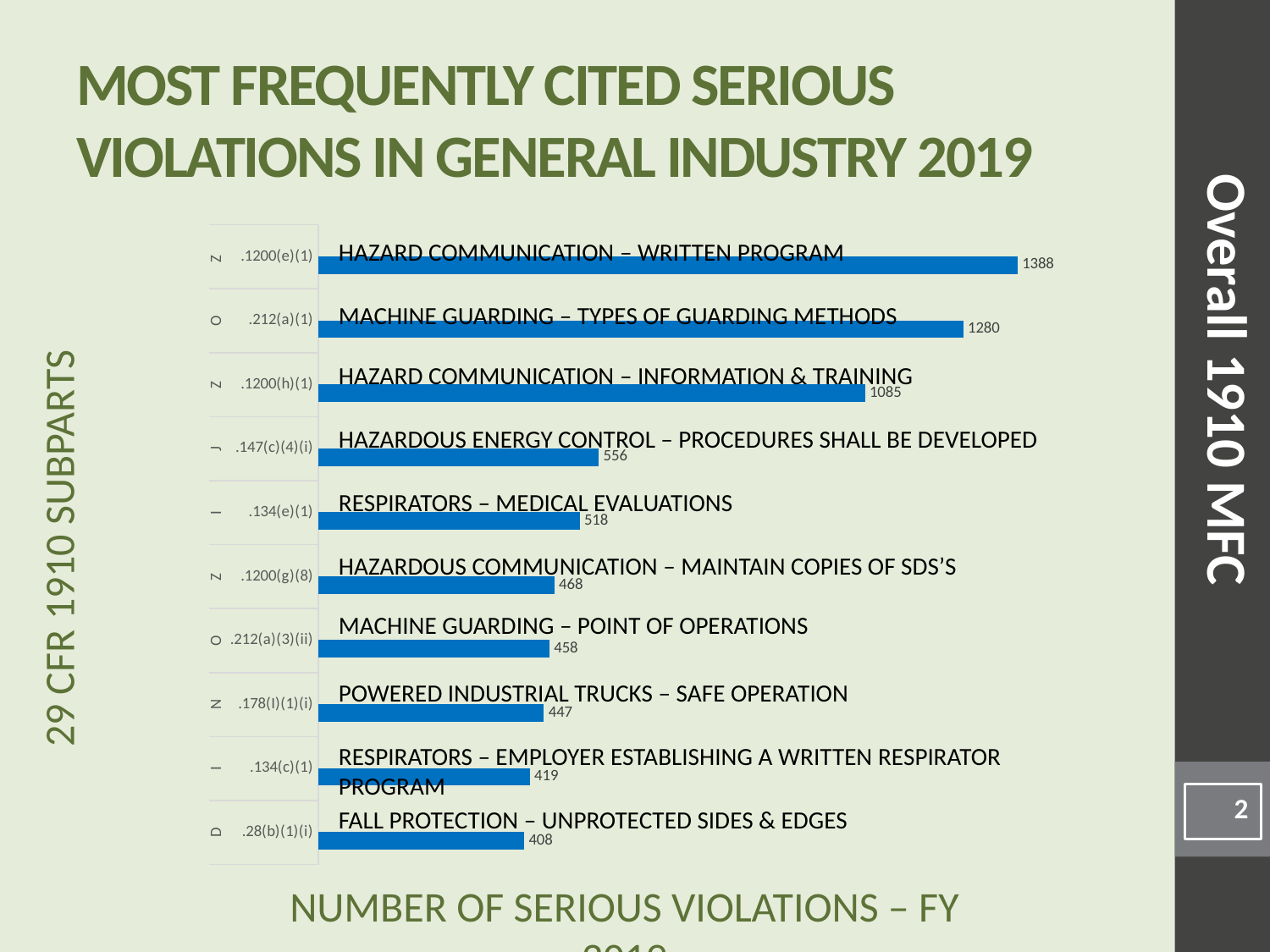
What is the number of serious violations for Hazard Communication – Written Program (.1200(e)(1))? 1388 What is the value shown for Fall Protection – Unprotected Sides & Edges (.28(b)(1)(i))? 408 Which has a larger value: Hazard Communication – Information & Training or Powered Industrial Trucks – Safe Operation? Hazard Communication – Information & Training What is the difference between the values for Hazard Communication – Written Program and Machine Guarding – Types of Guarding Methods? 108 What is the value shown for Respirators – Medical Evaluations (.134(e)(1))? 518 How many violation categories are plotted in the chart? 10 What is the number of serious violations for Machine Guarding – Types of Guarding Methods (.212(a)(1))? 1280 What is the title of the slide? Most Frequently Cited Serious Violations in General Industry 2019 Which violation category has the lowest number of serious violations? Fall Protection – Unprotected Sides & Edges Which violation category has the highest number of serious violations? Hazard Communication – Written Program What kind of chart is shown on the slide? Bar chart What is the difference between the values for Hazardous Energy Control – Procedures Shall Be Developed and Respirators – Medical Evaluations? 38